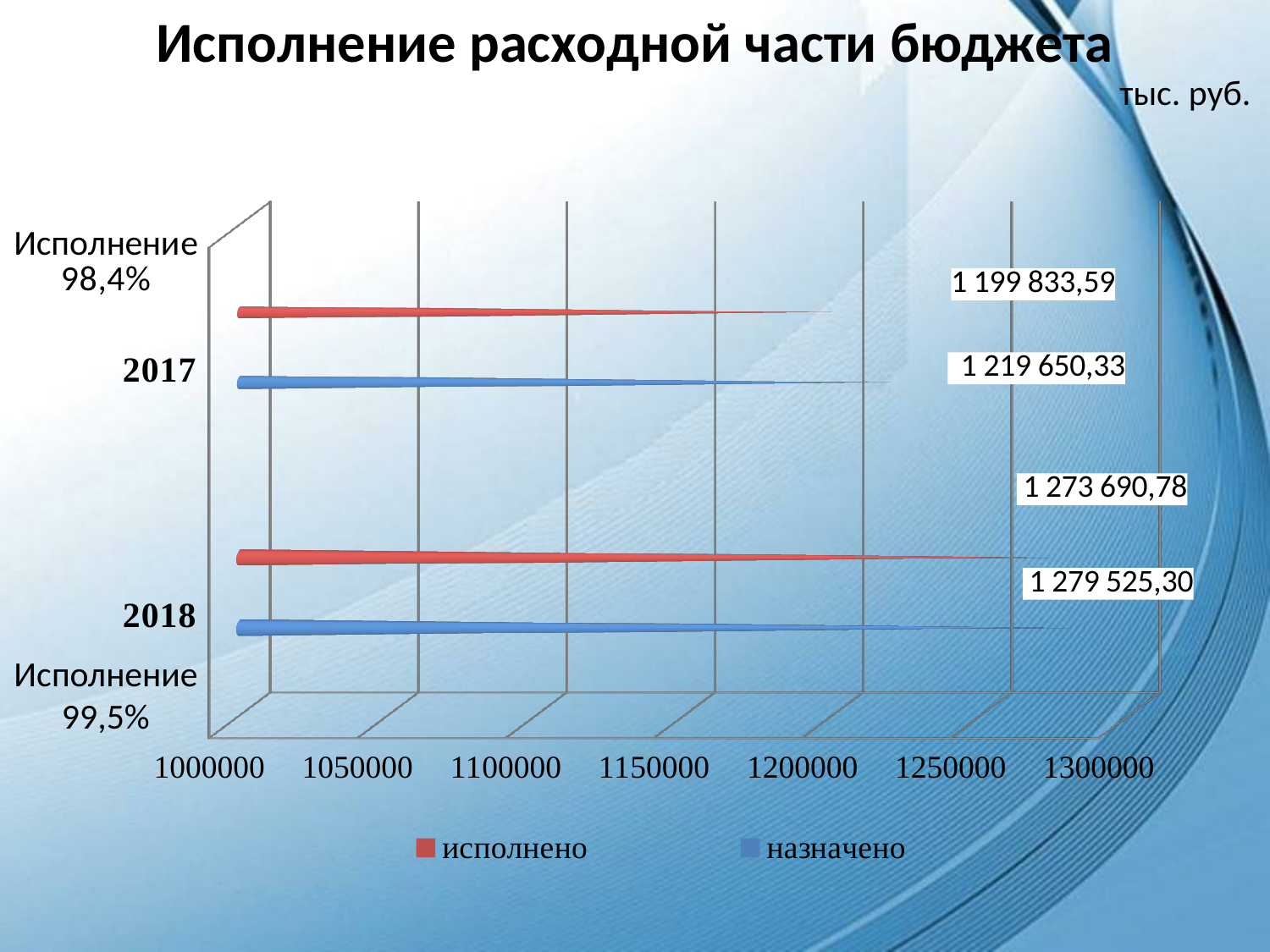
What type of chart is shown on the slide? bar chart What is the difference between назначено and исполнено for 2018? 5 834,52 What is the value of назначено for 2017? 1 219 650,33 What is the value of назначено for 2018? 1 279 525,30 What is the difference between назначено and исполнено for 2017? 19 816,74 Does the value of исполнено rise or fall from 2017 to 2018? rise Which year has the higher value of исполнено? 2018 How many years (categories) are shown on the chart? 2 What is the title of the chart? Исполнение расходной части бюджета What is the value of исполнено for 2018? 1 273 690,78 What is the value of исполнено for 2017? 1 199 833,59 How many series does the legend list? 2